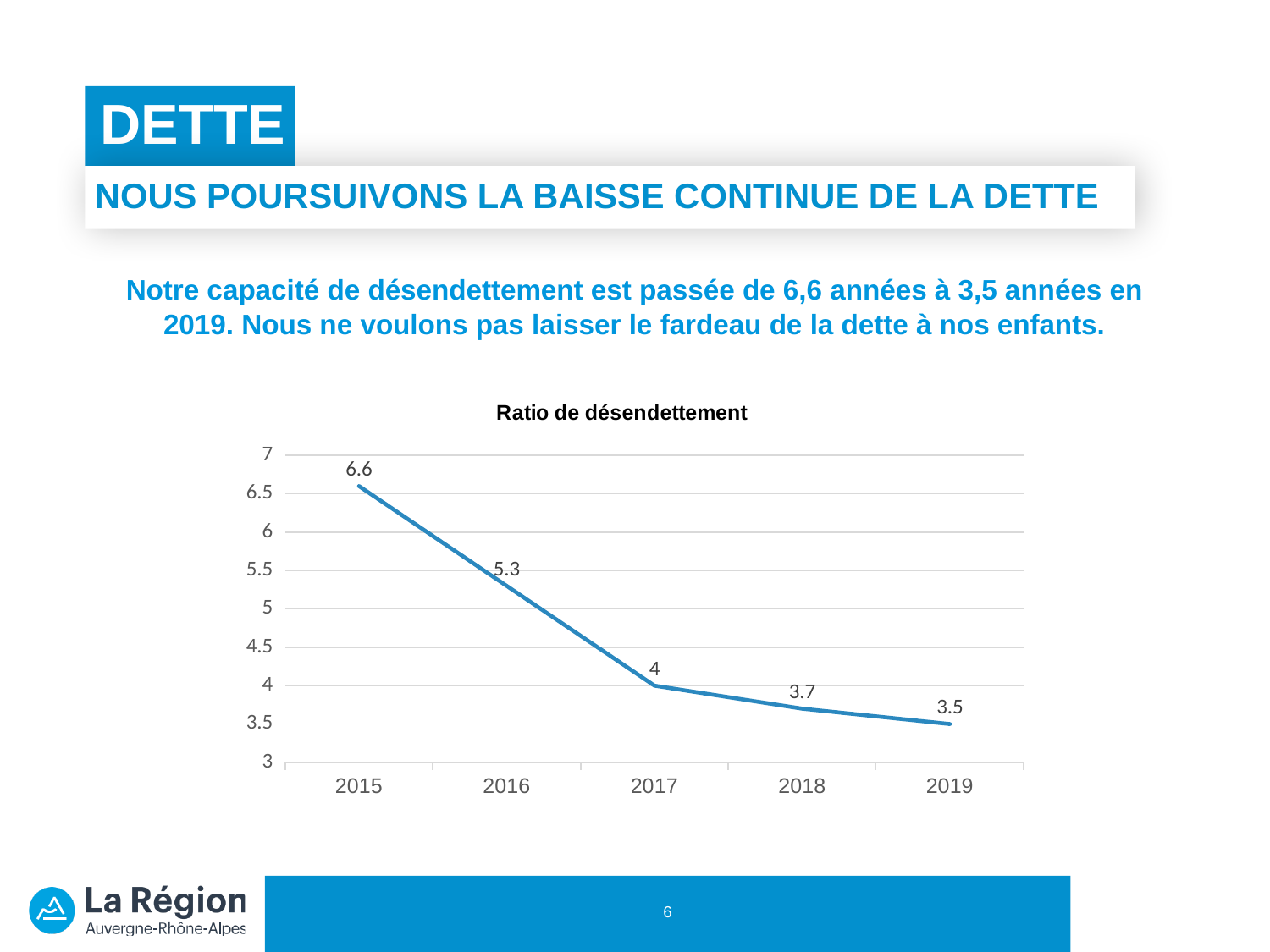
What is the value of the ratio de désendettement for 2019? 3.5 What is the difference between the ratio in 2016 and the ratio in 2017? 1.3 Which year has a larger ratio de désendettement, 2016 or 2018? 2016 What is the value of the ratio de désendettement for 2017? 4 Which year has the lowest ratio de désendettement? 2019 Is the value for 2018 greater or less than 4? less What is the difference between the ratio in 2015 and the ratio in 2019? 3.1 What is the value of the ratio de désendettement for 2015? 6.6 What kind of chart is shown on the slide? line chart Which year has the highest ratio de désendettement? 2015 How many years are plotted on the chart? 5 Do the values rise or fall from 2015 to 2019? fall